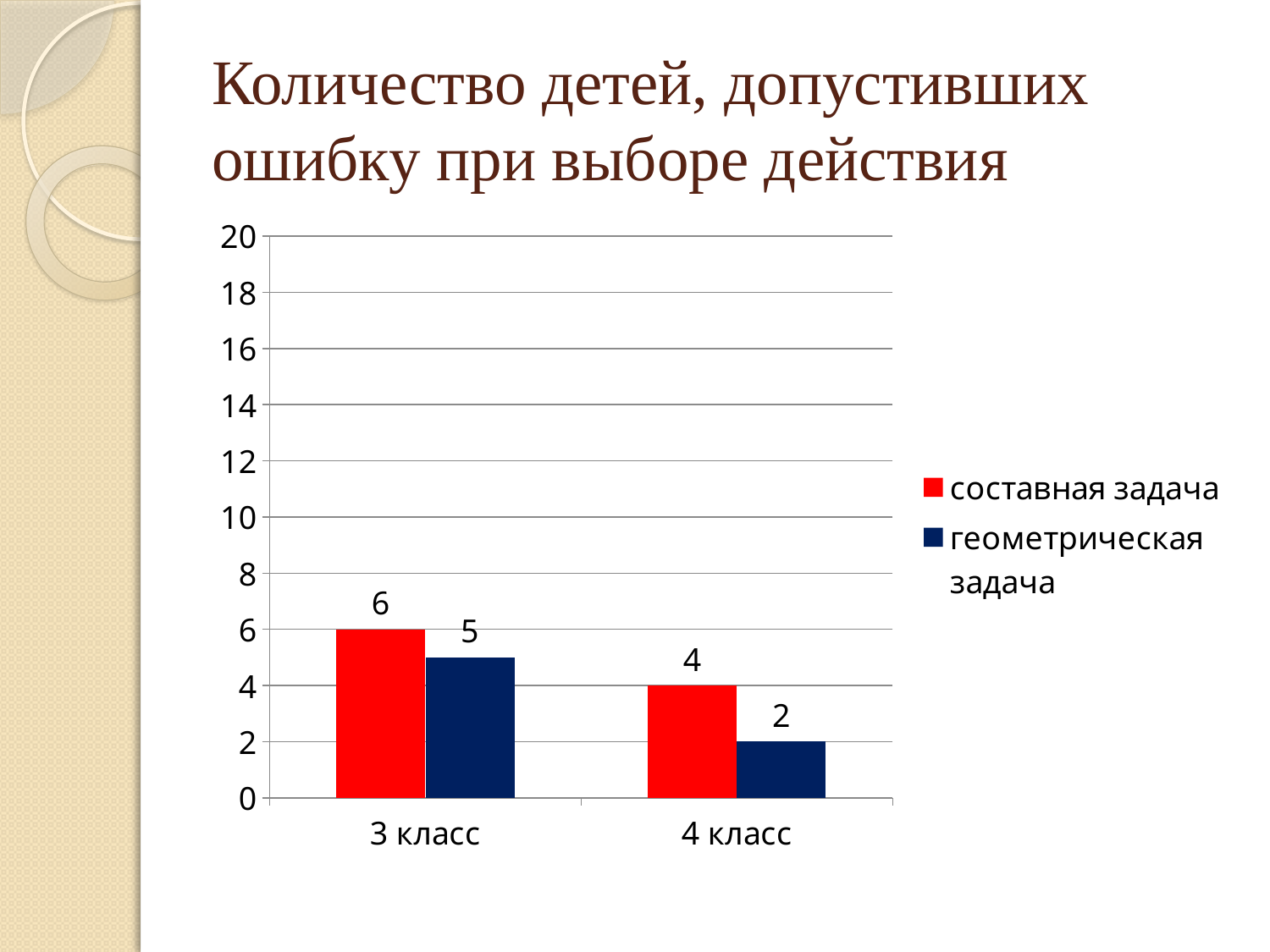
What is the value for геометрическая задача in 3 класс? 5 How many categories are shown on the x axis? 2 What is the value for геометрическая задача in 4 класс? 2 Do the values for составная задача rise or fall from 3 класс to 4 класс? fall What is the value for составная задача in 4 класс? 4 Which category has the highest value for составная задача? 3 класс Which is larger in 3 класс: составная задача or геометрическая задача? составная задача What is the difference between составная задача and геометрическая задача in 4 класс? 2 What kind of chart is shown on the slide? bar chart Which category has the lowest value for геометрическая задача? 4 класс How many series does the legend list? 2 What is the value for составная задача in 3 класс? 6